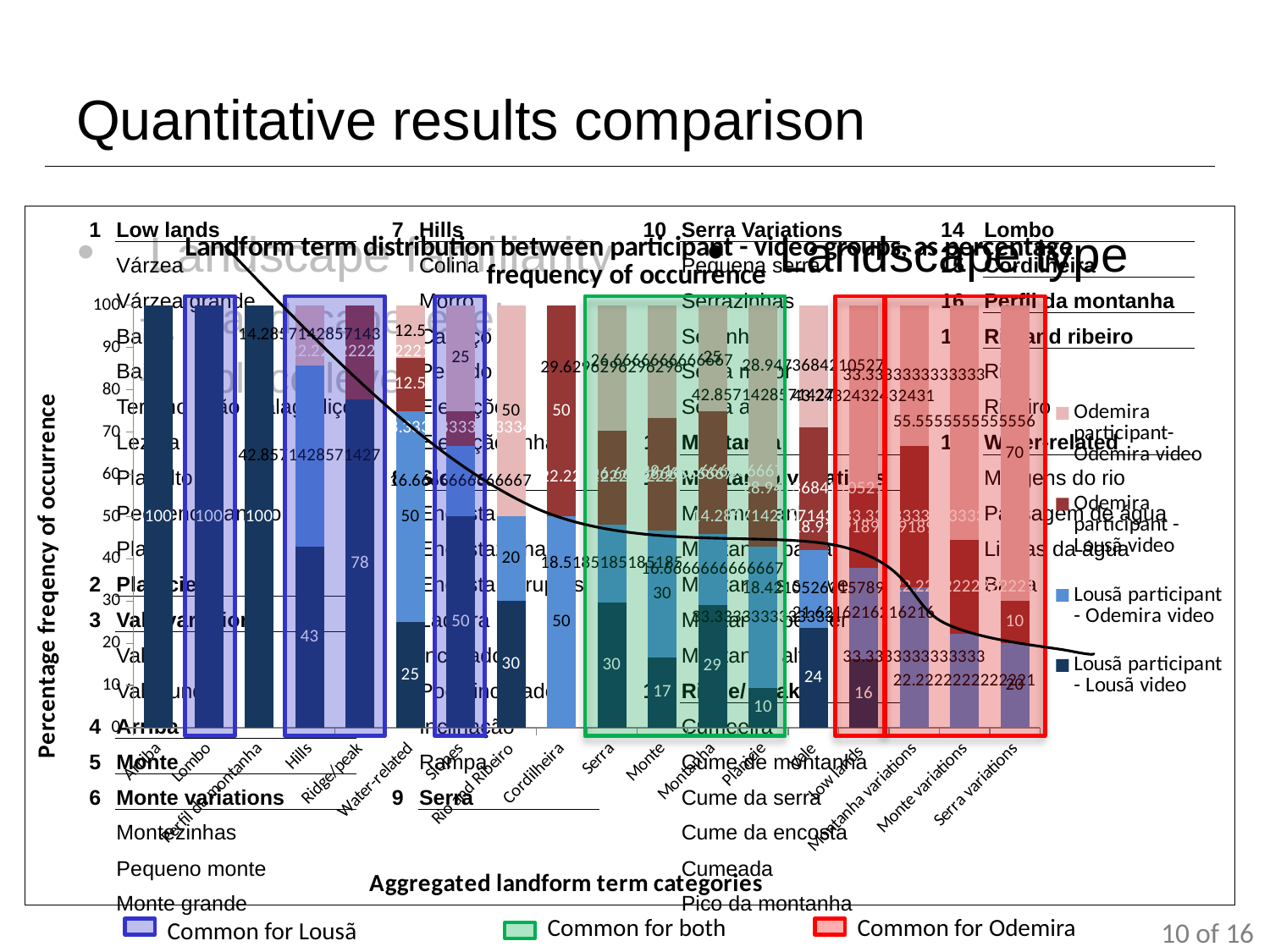
What is the title of the x axis of the chart? Aggregated landform term categories What is the title of the y axis of the chart? Percentage freqency of occurrence What is the value of the 'Lousã participant - Lousã video' series for Low lands? 16 Which is larger for the 'Lousã participant - Lousã video' series: Arriba or Hills? Arriba How many series does the chart legend list? 4 What is the value of the 'Lousã participant - Lousã video' series for Hills? 43 What is the value of the 'Lousã participant - Lousã video' series for Arriba? 100 What is the value of the 'Odemira participant-Odemira video' series for Serra variations? 70 What is the difference between the 'Lousã participant - Lousã video' values for Arriba and Hills? 57 What kind of chart is shown on the slide? stacked bar chart How many landform term categories are shown along the x axis of the chart? 18